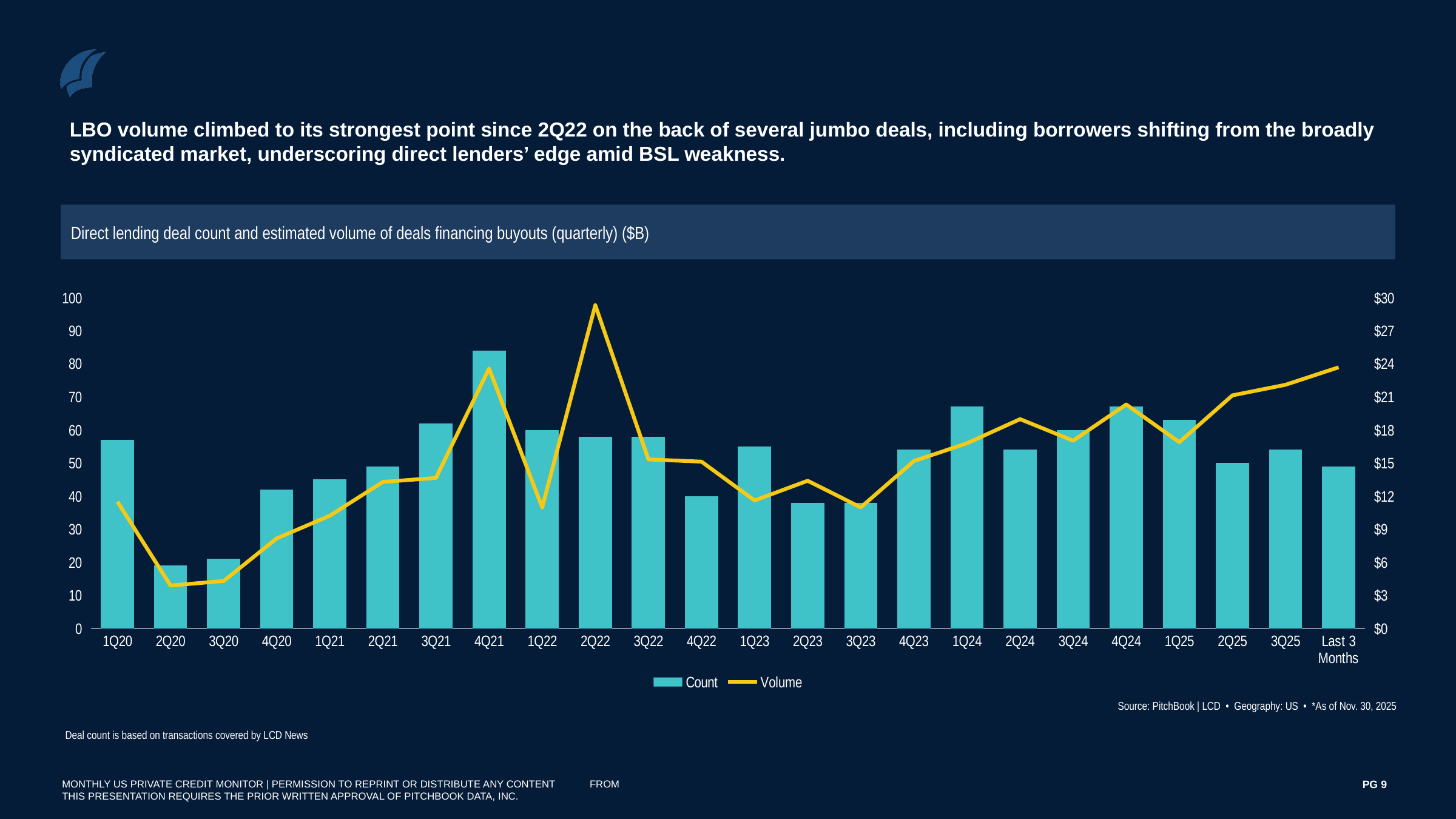
Which series is drawn as a yellow line? Volume How many series does the legend list? 2 Does the Volume line rise or fall from 1Q25 to Last 3 Months? rise What kind of chart is shown on the slide? A combined bar and line chart How many categories are shown along the x axis? 24 In which quarter does the Volume line reach its peak? 2Q22 Which has the larger deal count, 4Q21 or 1Q22? 4Q21 Which quarter has the highest deal count bar? 4Q21 Is the Volume for 2Q22 greater or less than $27? greater Is the deal count for 4Q21 greater or less than 80? greater Which quarter has the lowest deal count bar? 2Q20